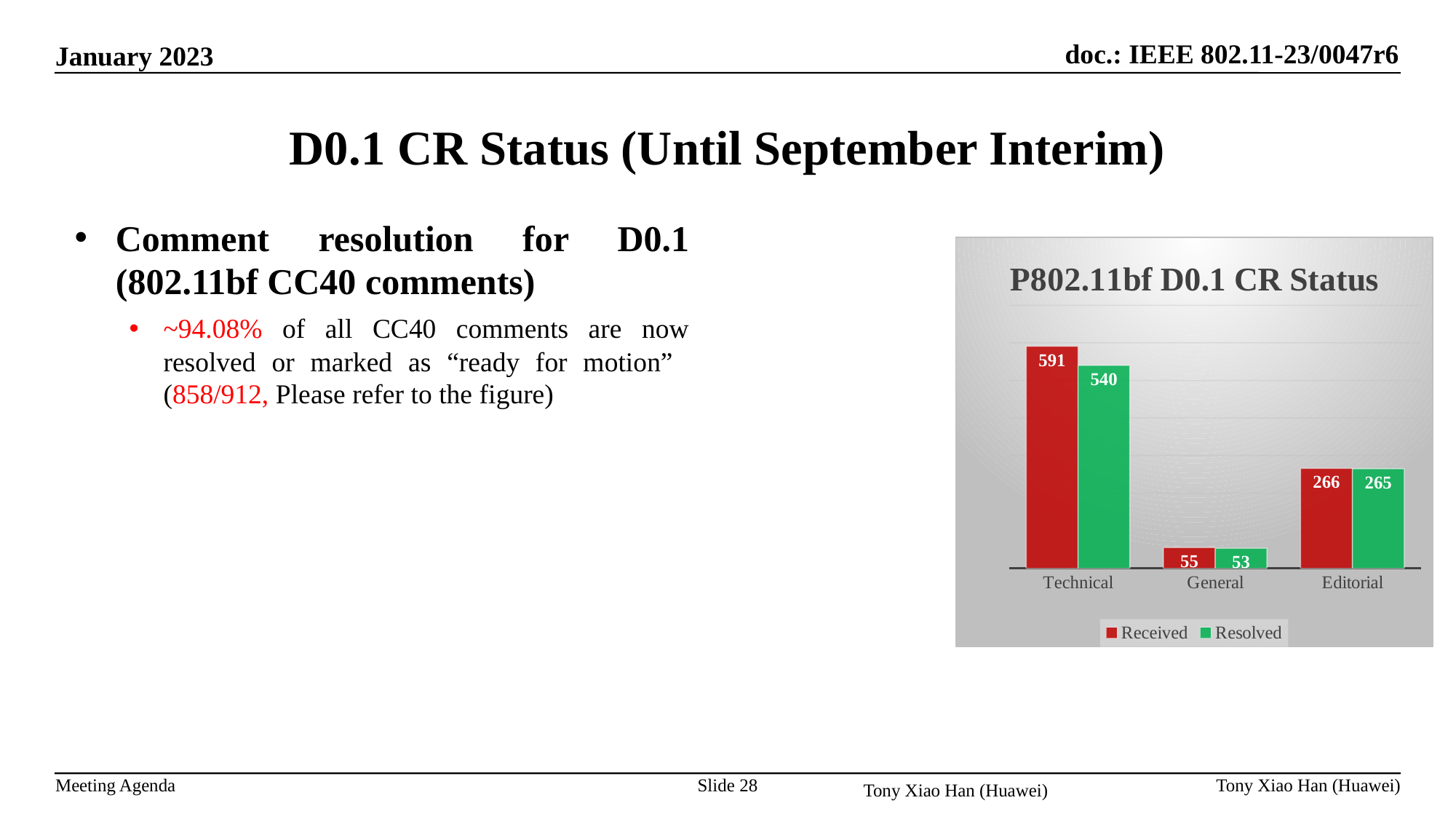
What is the Resolved value for General? 53 Which category has the lowest Resolved value? General What kind of chart is shown? bar chart How many series does the legend list? 2 What is the Received value for Technical? 591 What is the difference between the Received values for Editorial and General? 211 What is the difference between Received and Resolved for Technical? 51 What is the title of the chart? P802.11bf D0.1 CR Status Which is larger, the Resolved value for Technical or the Resolved value for Editorial? Technical Which category has the highest Received value? Technical How many categories are shown on the x axis? 3 What is the Resolved value for Editorial? 265